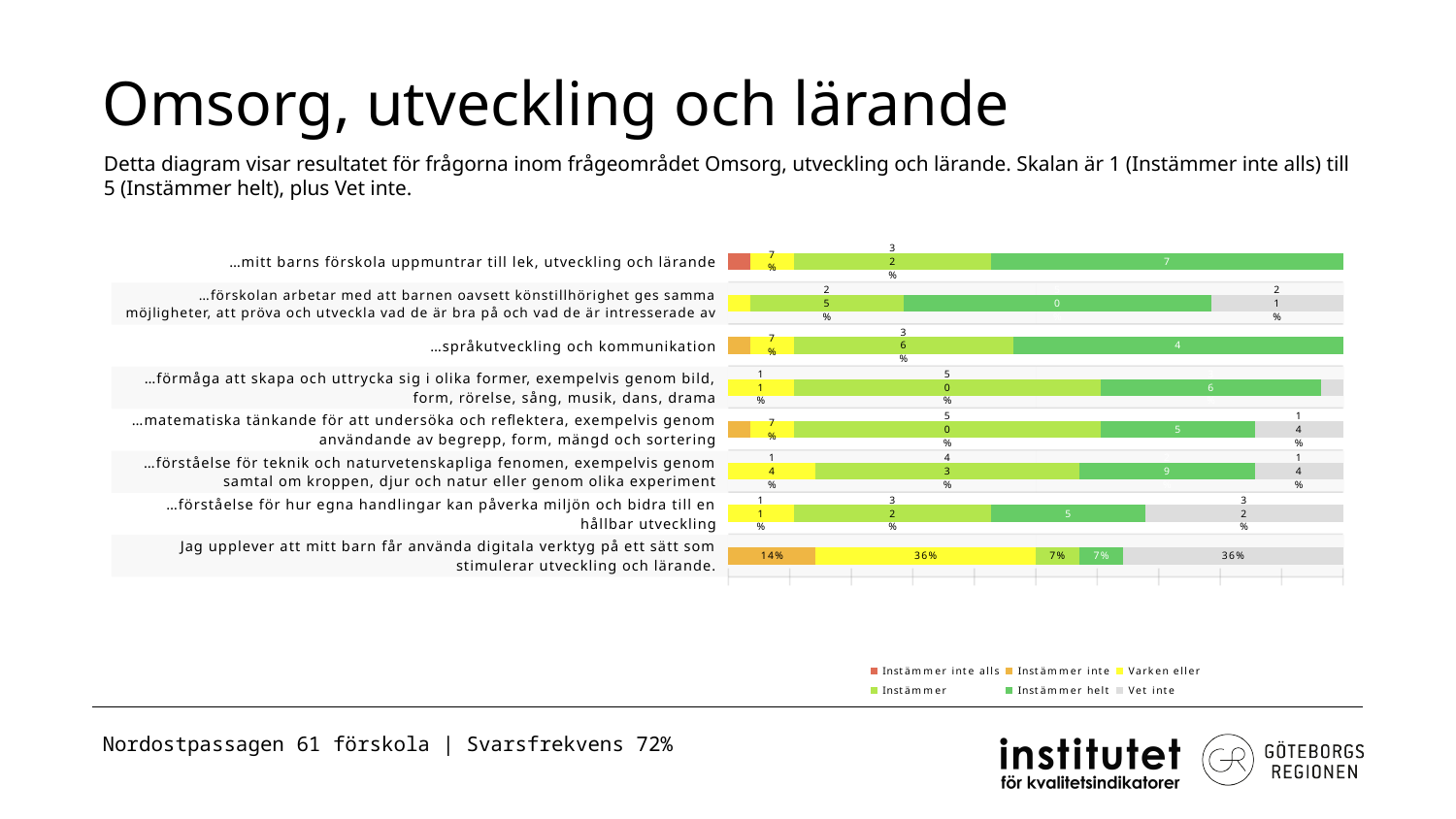
What is the 'Instämmer inte' share for the statement about digitala verktyg? 14% What is the total of all segments in the bar for the statement about digitala verktyg? 100% Which legend entry is shown in grey? Vet inte How many series does the legend list? 6 What kind of chart is shown on the slide? Stacked bar chart For the statement about digitala verktyg, which is larger: 'Instämmer inte' or 'Instämmer helt'? Instämmer inte What is the 'Instämmer' share for the statement '…förståelse för teknik och naturvetenskapliga fenomen, exempelvis genom samtal om kroppen, djur och natur eller genom olika experiment'? 43% What is the 'Varken eller' share for the statement about digitala verktyg? 36% How many statements (categories) are plotted in the chart? 8 For the statement about digitala verktyg, what is the difference between the 'Varken eller' share and the 'Instämmer inte' share? 22% What is the 'Vet inte' share for the statement 'Jag upplever att mitt barn får använda digitala verktyg på ett sätt som stimulerar utveckling och lärande'? 36% What is the 'Instämmer helt' share for the statement about digitala verktyg? 7%